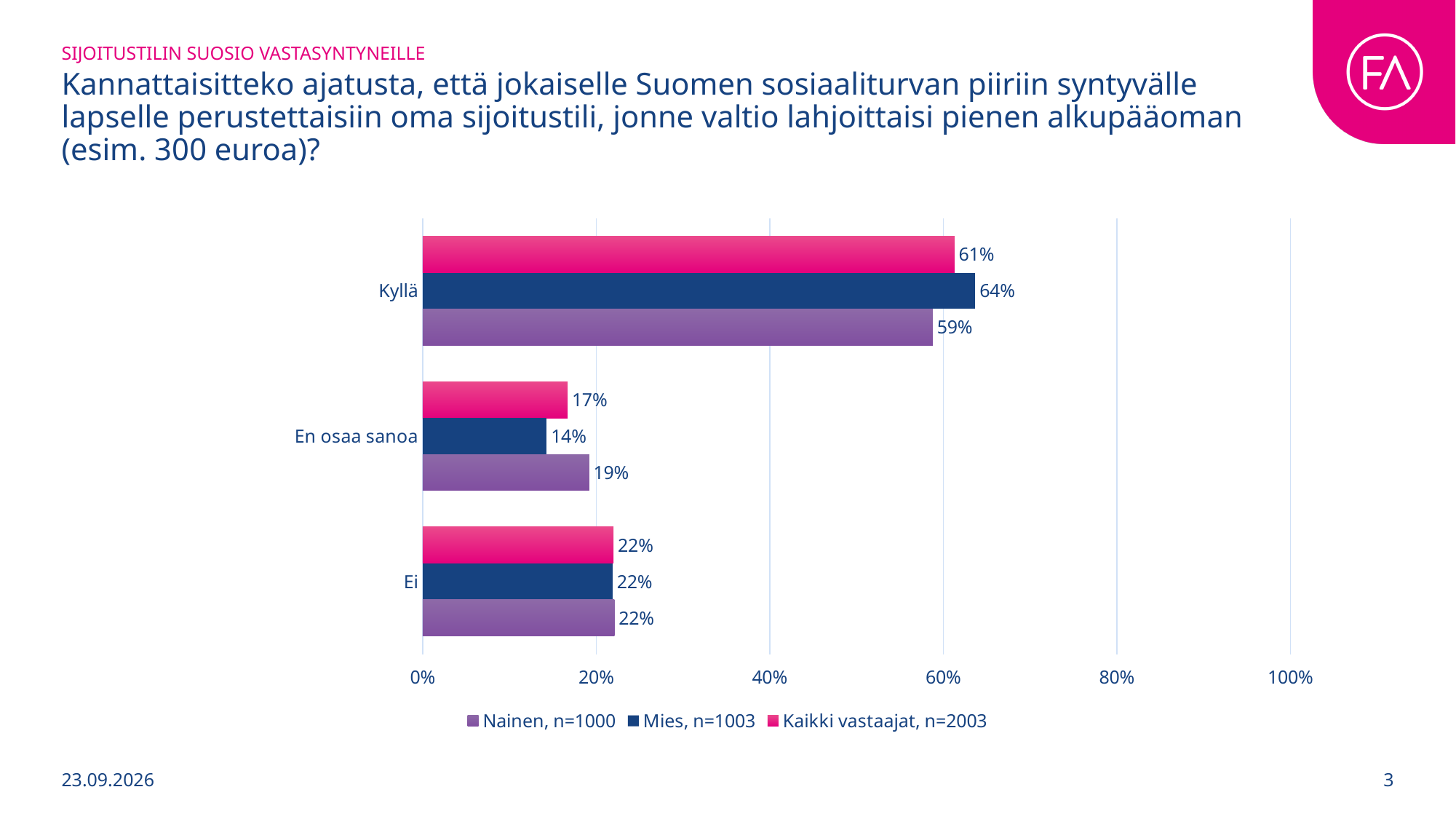
What kind of chart is shown on the slide? Bar chart Is the value for "Kyllä" in the "Nainen, n=1000" series greater or less than 40%? greater How many categories are shown on the chart? 3 How many series does the legend list? 3 Which category has the highest value in the "Kaikki vastaajat, n=2003" series? Kyllä Which category has the lowest value in the "Mies, n=1003" series? En osaa sanoa For "En osaa sanoa", which series has the larger value: "Nainen, n=1000" or "Mies, n=1003"? Nainen, n=1000 What is the value for "En osaa sanoa" in the "Nainen, n=1000" series? 19% Which series is shown in pink? Kaikki vastaajat, n=2003 What is the difference between the "Mies, n=1003" and "Nainen, n=1000" values for "Kyllä"? 5% What is the value for "Ei" in the "Kaikki vastaajat, n=2003" series? 22% What is the value for "Kyllä" in the "Mies, n=1003" series? 64%